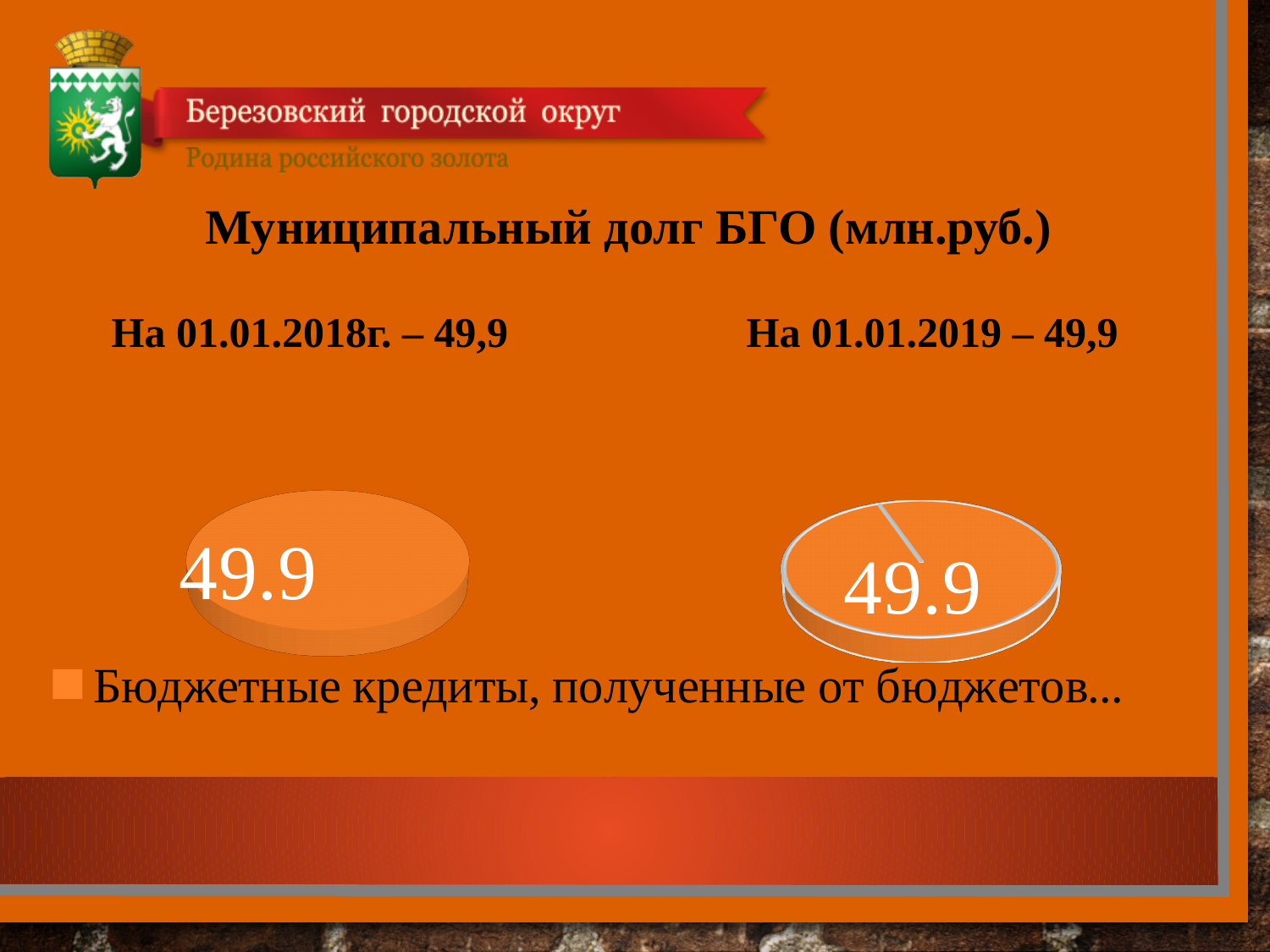
In the left pie chart (На 01.01.2018г.), what value is printed on the slice? 49.9 In the left pie chart (На 01.01.2018г.), what share of the pie does the single slice take? 100% How many slices does the right pie chart (На 01.01.2019) contain? 1 Is the value in the left pie chart (На 01.01.2018г.) larger than, smaller than, or equal to the value in the right pie chart (На 01.01.2019)? equal What is the legend entry shown below the pie charts? Бюджетные кредиты, полученные от бюджетов... How many slices does the left pie chart (На 01.01.2018г.) contain? 1 How many entries does the legend below the pie charts list? 1 What kind of chart is shown on the left of the slide? pie chart What is the title above the two pie charts? Муниципальный долг БГО (млн.руб.) What kind of chart is shown on the right of the slide? pie chart In the right pie chart (На 01.01.2019), what value is printed on the slice? 49.9